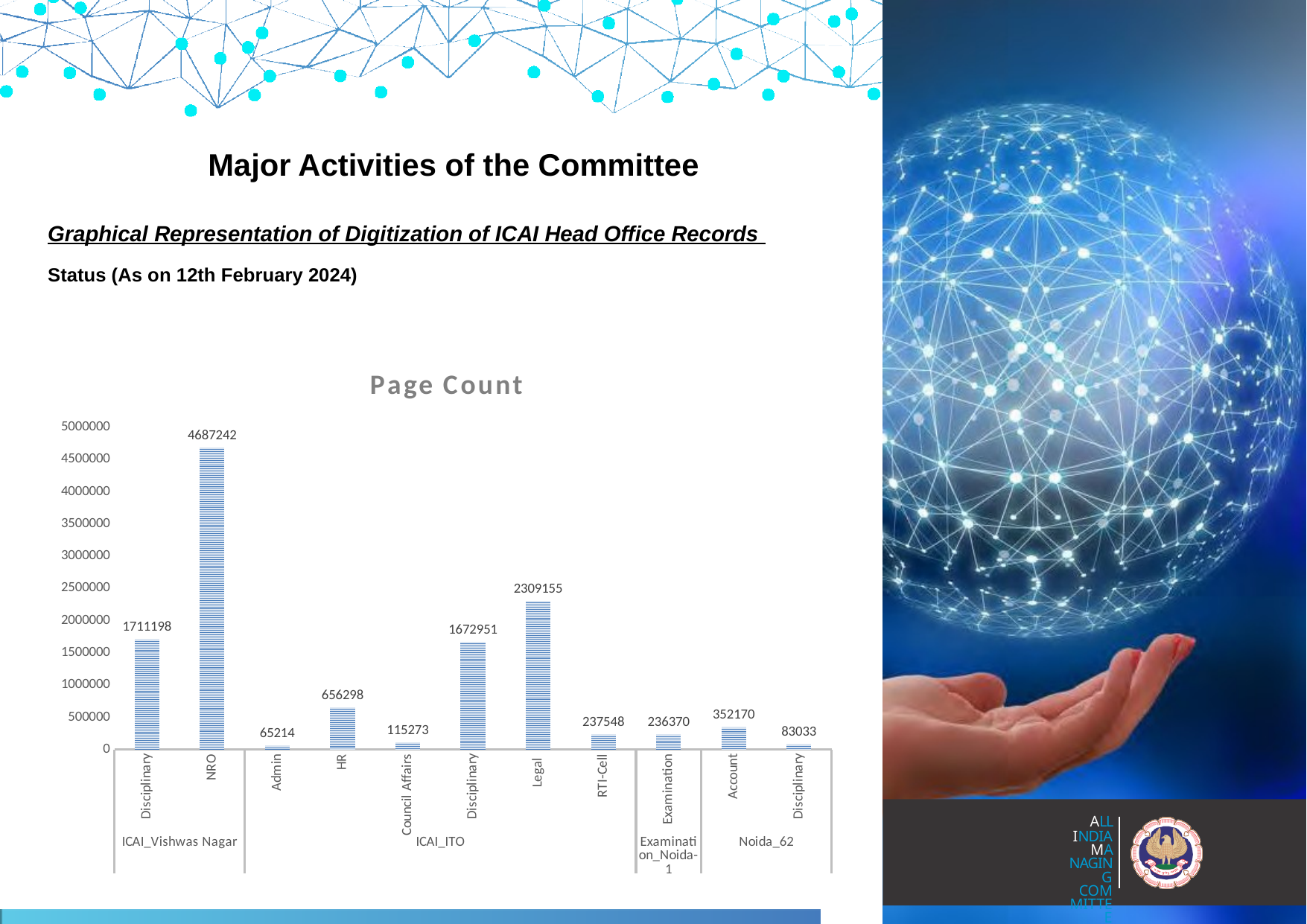
Which category has the highest page count? NRO Which category has the lowest page count? Admin What type of chart is shown on the slide? bar chart How many bars are plotted in the chart? 11 What is the difference in page count between HR and Council Affairs under ICAI_ITO? 541025 What is the difference in page count between NRO and Legal? 2378087 What is the page count for Examination under Examination_Noida-1? 236370 What is the page count for NRO under ICAI_Vishwas Nagar? 4687242 What is the page count for Account under Noida_62? 352170 What is the page count for Legal under ICAI_ITO? 2309155 What is the title of the chart? Page Count Which has a larger page count: Disciplinary under ICAI_Vishwas Nagar or Disciplinary under ICAI_ITO? Disciplinary under ICAI_Vishwas Nagar